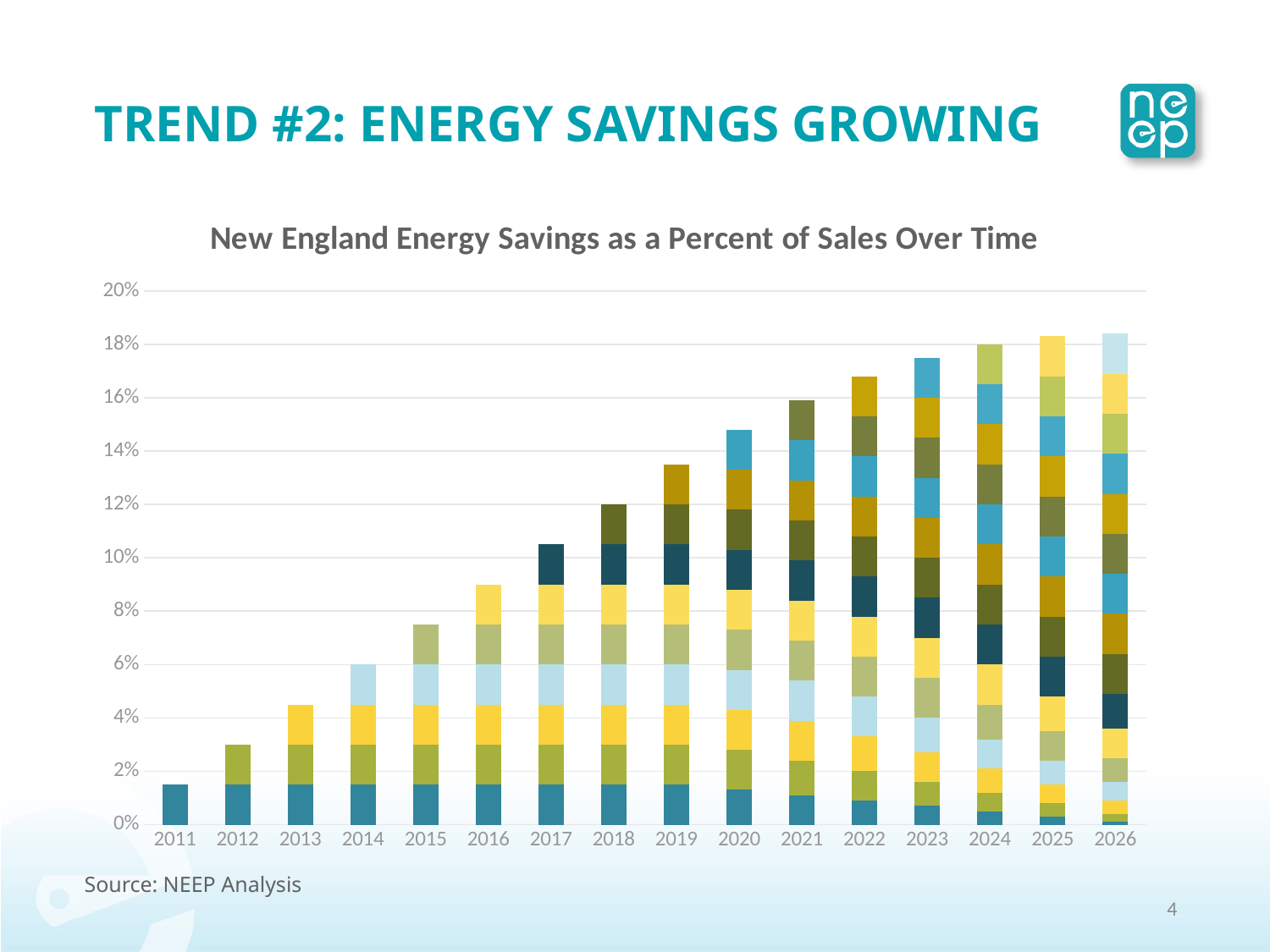
Which year has the tallest bar? 2026 Which year has the shortest bar? 2011 What kind of chart is shown on the slide? bar chart Do the total bar heights rise or fall from 2011 to 2026? rise How many years are shown along the x axis of the chart? 16 Which year has the taller bar, 2015 or 2020? 2020 Is the total value for 2023 greater or less than 16%? greater Is the total value for 2021 greater or less than 14%? greater What is the total value of the bar for 2014? 6% Is the total value for 2011 greater or less than 2%? less What is the title of the chart? New England Energy Savings as a Percent of Sales Over Time